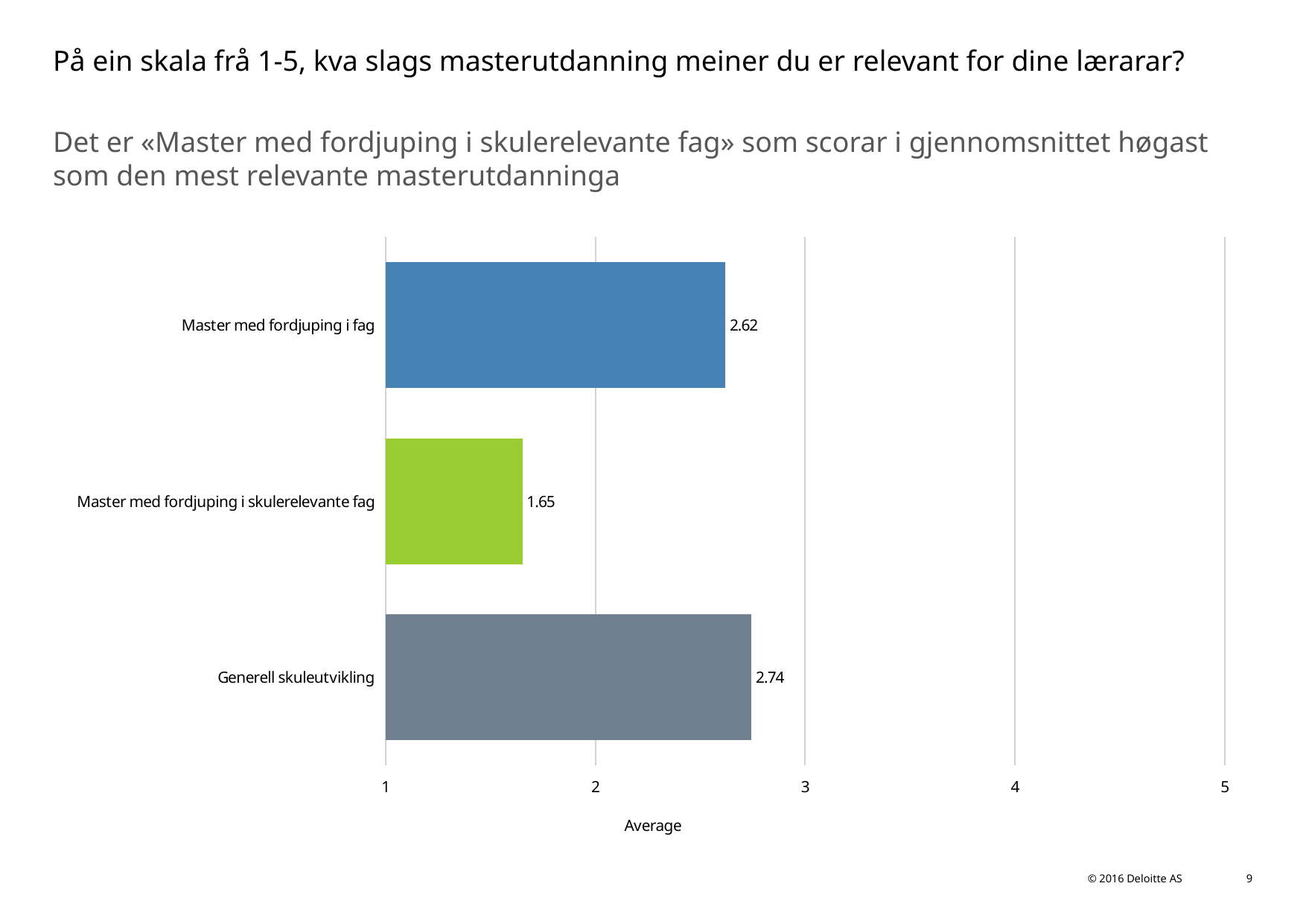
Is the value for "Generell skuleutvikling" greater or less than 3? less What is the average value for "Master med fordjuping i skulerelevante fag"? 1.65 What is the difference between the values for "Generell skuleutvikling" and "Master med fordjuping i fag"? 0.12 What is the difference between the values for "Master med fordjuping i fag" and "Master med fordjuping i skulerelevante fag"? 0.97 What is the average value for "Generell skuleutvikling"? 2.74 Which category has the lowest average value? Master med fordjuping i skulerelevante fag How many categories are shown in the chart? 3 What kind of chart is shown on the slide? Bar chart Which is larger: the value for "Master med fordjuping i fag" or for "Master med fordjuping i skulerelevante fag"? Master med fordjuping i fag What is the label on the horizontal axis of the chart? Average What is the average value for "Master med fordjuping i fag"? 2.62 Which category has the highest average value? Generell skuleutvikling